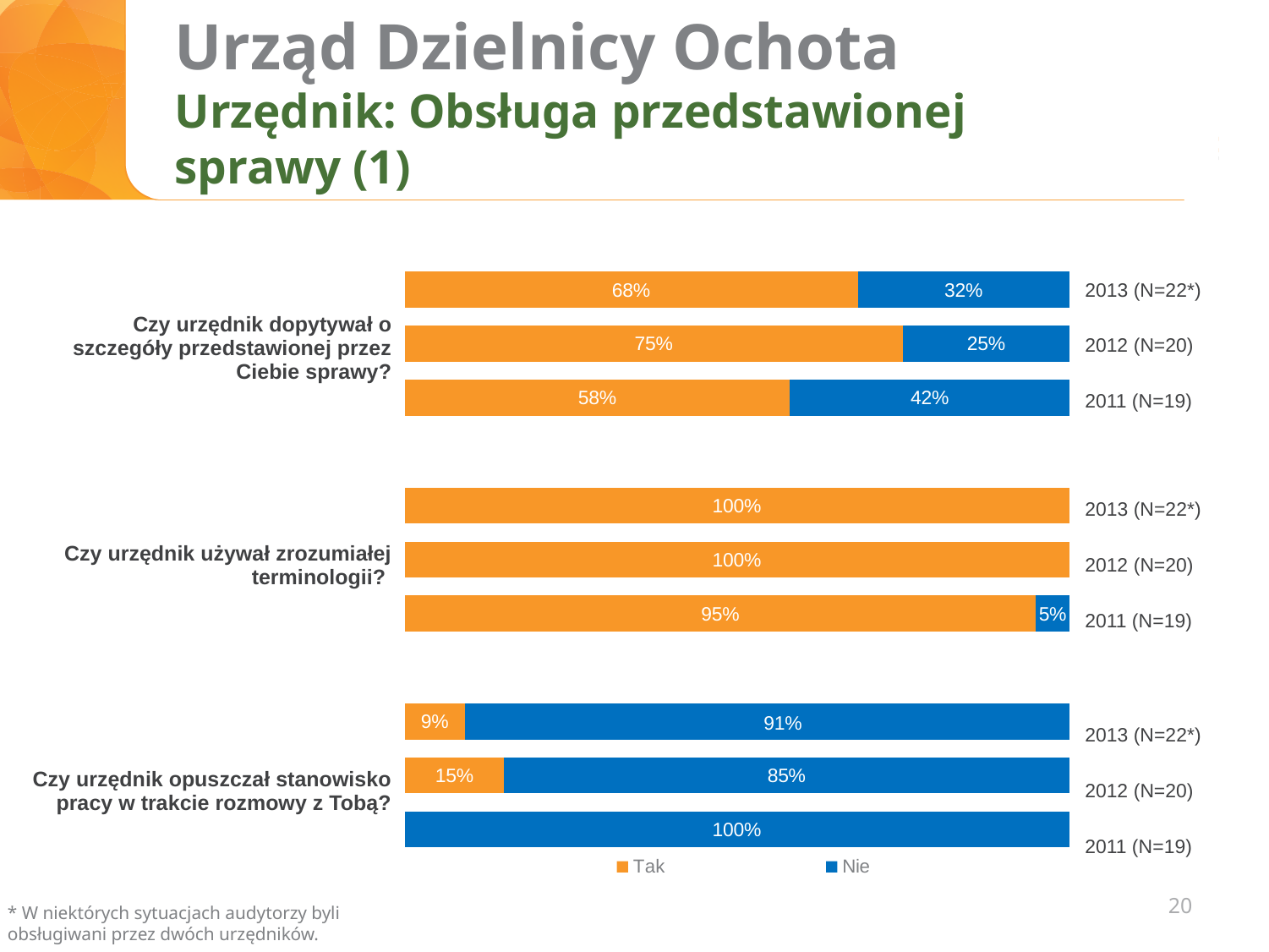
For the question "Czy urzędnik opuszczał stanowisko pracy w trakcie rozmowy z Tobą?", which year had the lowest "Tak" share? 2011 What percentage answered "Tak" in 2013 to the question "Czy urzędnik dopytywał o szczegóły przedstawionej przez Ciebie sprawy?"? 68% For the question "Czy urzędnik opuszczał stanowisko pracy w trakcie rozmowy z Tobą?", is the "Tak" share larger in 2013 or in 2012? 2012 What percentage answered "Nie" in 2011 to the question "Czy urzędnik dopytywał o szczegóły przedstawionej przez Ciebie sprawy?"? 42% What percentage answered "Nie" in 2012 to the question "Czy urzędnik opuszczał stanowisko pracy w trakcie rozmowy z Tobą?"? 85% What percentage answered "Tak" in 2011 to the question "Czy urzędnik używał zrozumiałej terminologii?"? 95% What are the two series named in the legend? Tak and Nie How many bars are plotted in the chart in total? 9 What kind of chart is shown on the slide? stacked bar chart For the question "Czy urzędnik dopytywał o szczegóły przedstawionej przez Ciebie sprawy?", what is the difference between the "Tak" share in 2012 and in 2011? 17 percentage points For the question "Czy urzędnik dopytywał o szczegóły przedstawionej przez Ciebie sprawy?", which year had the highest "Tak" share? 2012 How many series does the legend list? 2